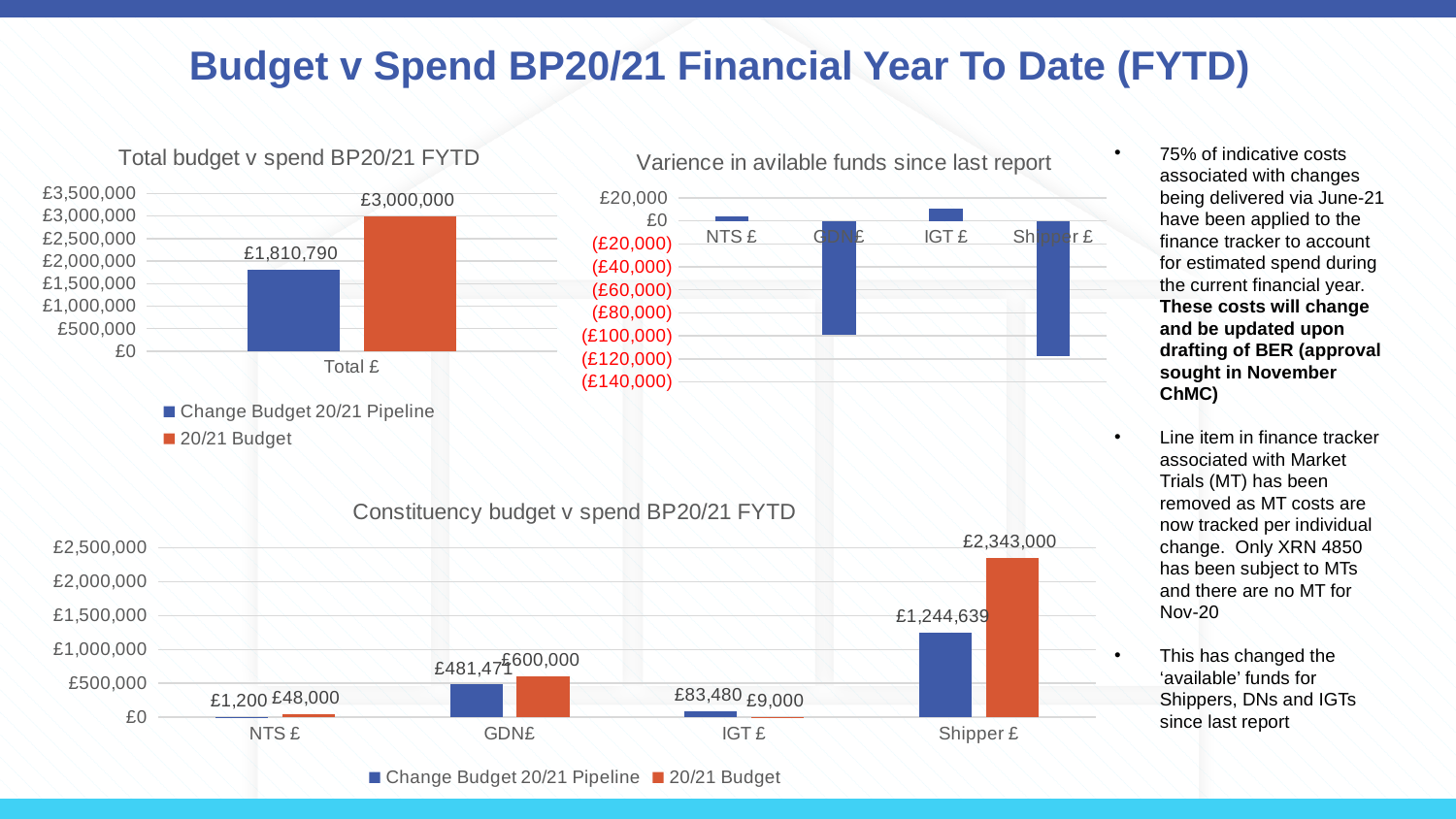
In the 'Constituency budget v spend BP20/21 FYTD' chart, which constituency has the highest Change Budget 20/21 Pipeline value? Shipper £ In the 'Varience in avilable funds since last report' chart, is the value for Shipper £ greater or less than (£100,000)? less In the 'Constituency budget v spend BP20/21 FYTD' chart, what is the 20/21 Budget value for Shipper £? £2,343,000 How many categories are shown on the x axis of the 'Constituency budget v spend BP20/21 FYTD' chart? 4 In the 'Constituency budget v spend BP20/21 FYTD' chart, what is the difference between the 20/21 Budget and the Change Budget 20/21 Pipeline for NTS £? £46,800 In the 'Total budget v spend BP20/21 FYTD' chart, what is the value of the 20/21 Budget bar? £3,000,000 In the 'Constituency budget v spend BP20/21 FYTD' chart, for IGT £, which is larger: the Change Budget 20/21 Pipeline or the 20/21 Budget? Change Budget 20/21 Pipeline What kind of chart is the 'Varience in avilable funds since last report' chart? Bar chart In the 'Total budget v spend BP20/21 FYTD' chart, what is the value of the Change Budget 20/21 Pipeline bar? £1,810,790 In the 'Constituency budget v spend BP20/21 FYTD' chart, which constituency has the lowest 20/21 Budget value? IGT £ In the 'Total budget v spend BP20/21 FYTD' chart, what is the difference between the 20/21 Budget and the Change Budget 20/21 Pipeline? £1,189,210 In the 'Constituency budget v spend BP20/21 FYTD' chart, what is the Change Budget 20/21 Pipeline value for GDN£? £481,471